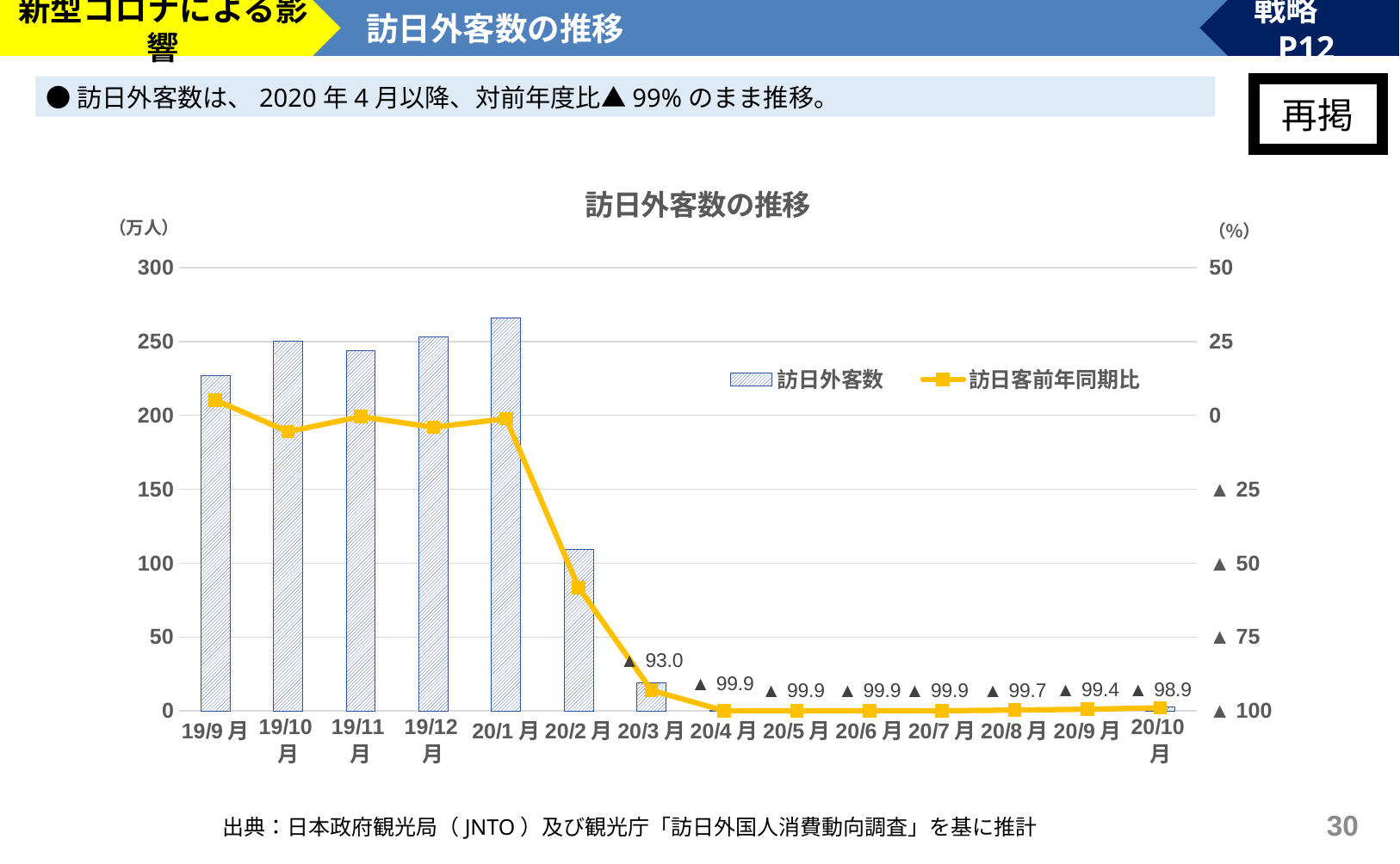
Is the 訪日外客数 bar for 20/1月 greater or less than 250? greater What is the value of 訪日客前年同期比 for 20/9月? ▲ 99.4 What kind of chart is shown on the slide? Combined bar and line chart Which month has the highest 訪日外客数 bar? 20/1月 How many series does the chart legend list? 2 What is the unit shown on the left vertical axis of the chart? 万人 Which is larger, the 訪日外客数 bar for 20/2月 or for 20/3月? 20/2月 What is the value of 訪日客前年同期比 for 20/8月? ▲ 99.7 Is the 訪日外客数 bar for 19/9月 greater or less than 250? less What is the value of 訪日客前年同期比 for 20/3月? ▲ 93.0 How many months are shown on the x axis of the chart? 14 What is the value of 訪日客前年同期比 for 20/10月? ▲ 98.9